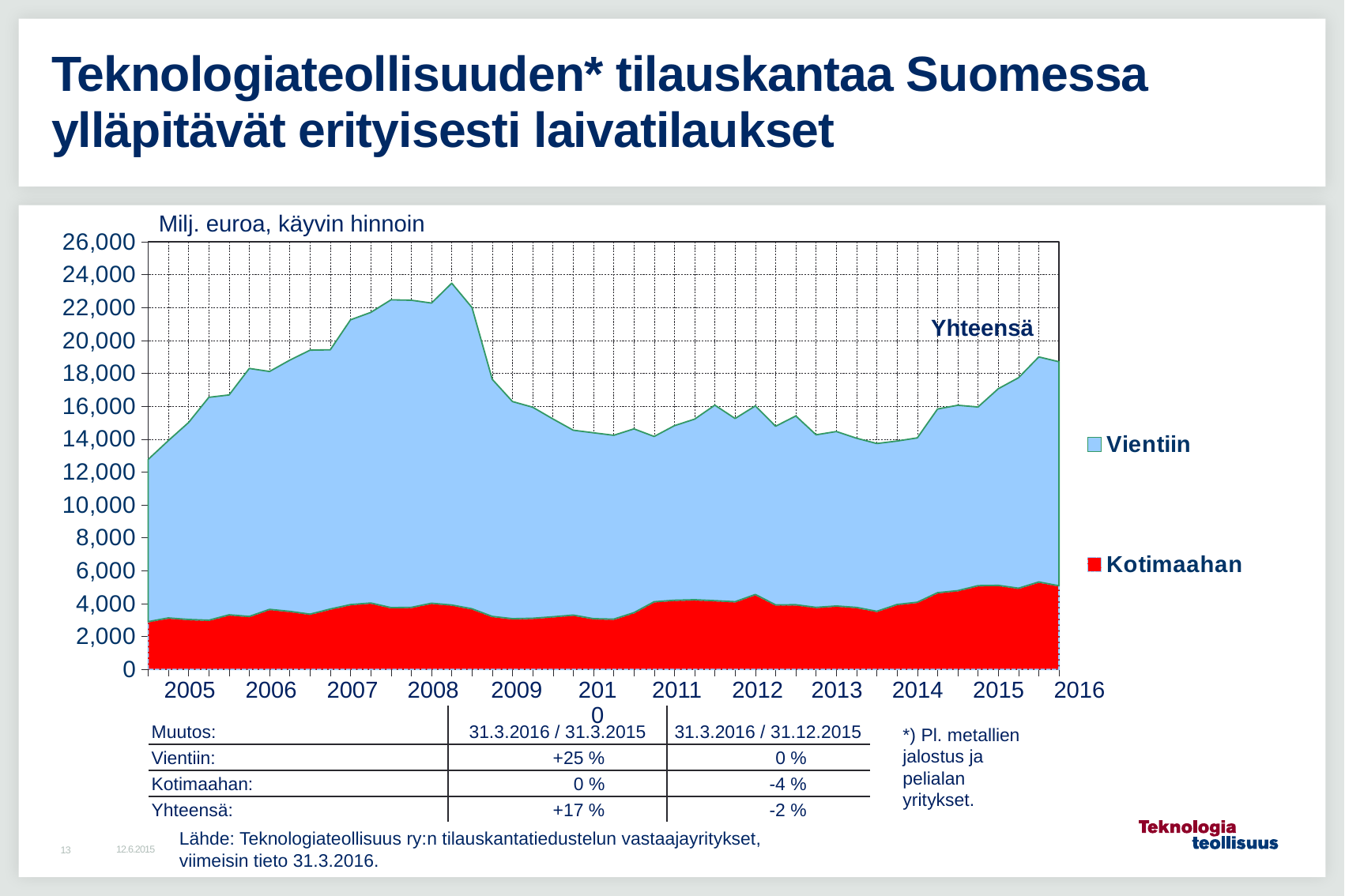
Which series is larger throughout the chart, Vientiin or Kotimaahan? Vientiin What are the two series named in the chart legend? Vientiin and Kotimaahan How many series does the chart legend list? 2 Is the total value at the start of 2005 greater or less than 14,000? less Is the peak total value in 2008 greater or less than 22,000? greater What kind of chart is shown on the slide? Stacked area chart Is the total value in 2013 greater or less than 16,000? less Does the total order backlog rise or fall between 2014 and 2016? rise In which year does the total (Yhteensä) order backlog reach its highest peak? 2008 Does the total order backlog rise or fall between 2008 and 2009? fall What unit label is shown above the chart's vertical axis? Milj. euroa, käyvin hinnoin